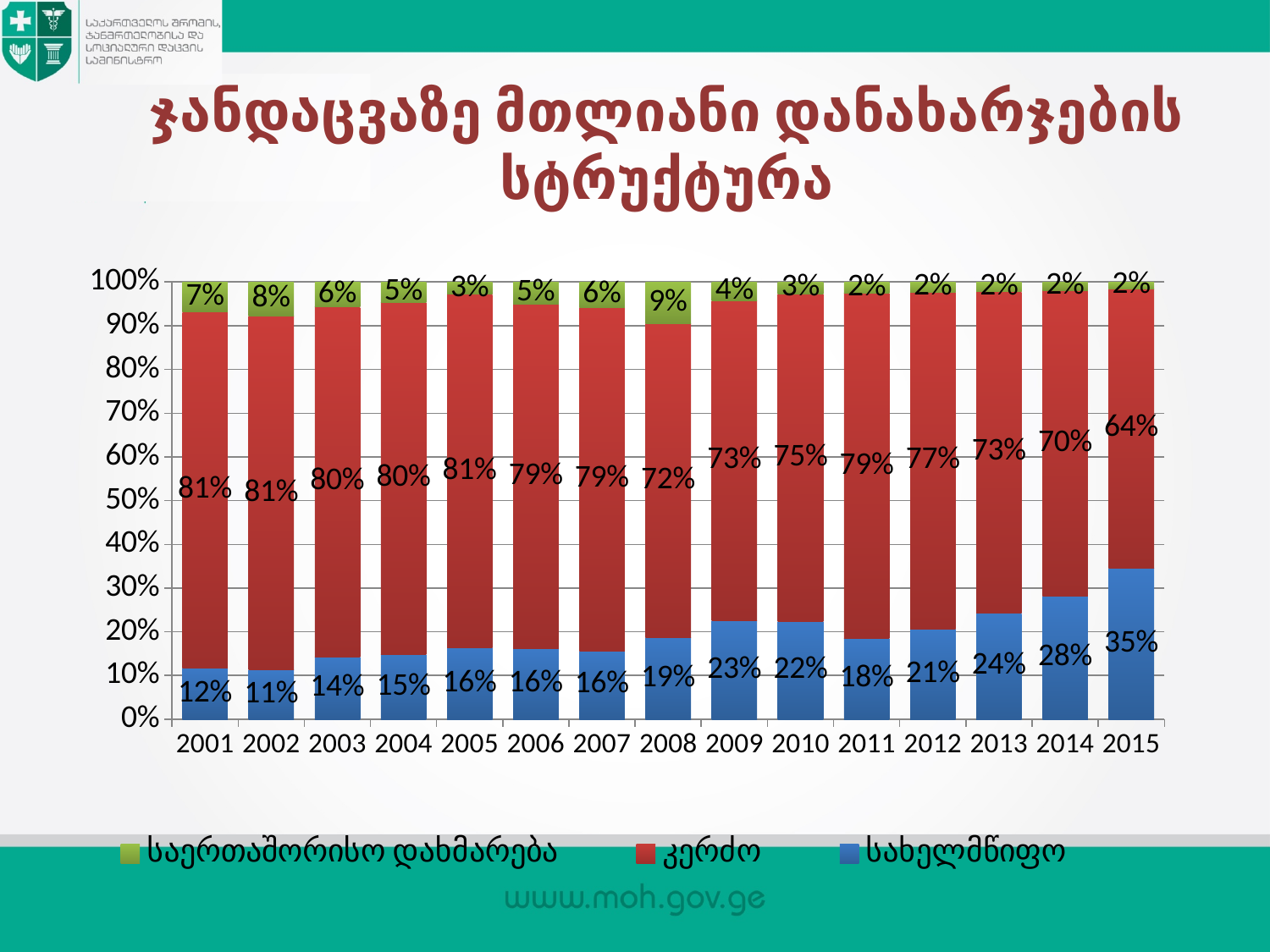
In which year is the სახელმწიფო share highest? 2015 Which is larger, the კერძო value in 2001 or in 2015? 2001 Which colour represents კერძო in the chart? red In which year is the კერძო share lowest? 2015 Does the სახელმწიფო share generally rise or fall from 2001 to 2015? rise What is the value for კერძო in 2008? 72% What is the value for საერთაშორისო დახმარება in 2008? 9% How many series does the legend list? 3 What is the value for სახელმწიფო in 2015? 35% How many years are shown on the x axis? 15 What kind of chart is shown on the slide? stacked bar chart What is the difference between the სახელმწიფო values in 2015 and 2001? 23%